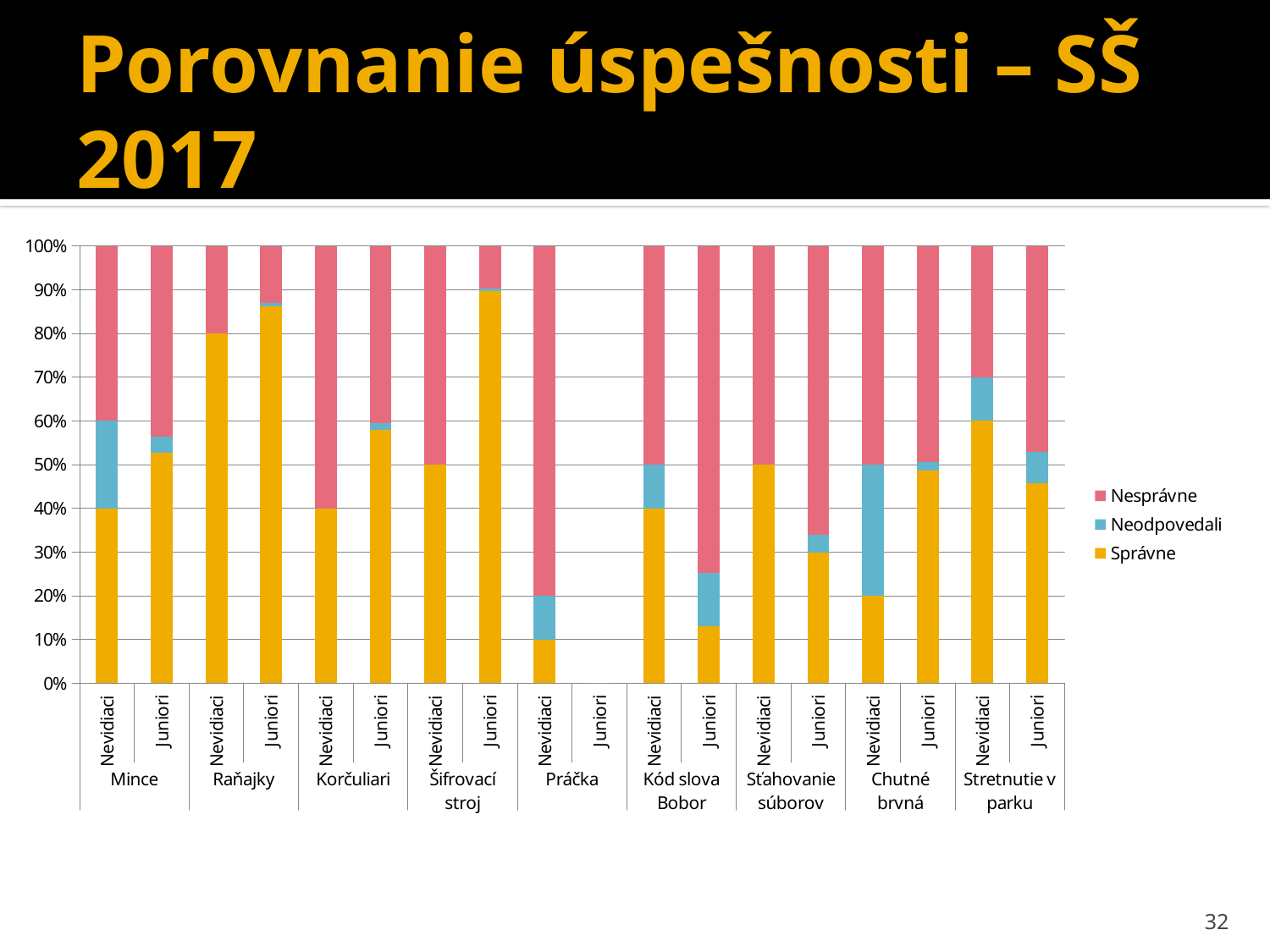
Is the Správne share for Juniori in the Raňajky task greater or less than 80%? greater How many task groups are shown along the x axis? 9 What is the Správne share for Nevidiaci in the Práčka task? 10% Which task has no bar plotted for Juniori? Práčka What is the Správne share for Nevidiaci in the Mince task? 40% Is the Správne share for Juniori in the Kód slova Bobor task greater or less than 20%? less What is the Správne share for Nevidiaci in the Raňajky task? 80% What are the three series named in the legend? Nesprávne, Neodpovedali, Správne How many series does the legend list? 3 What kind of chart is shown on the slide? Stacked bar chart In the Chutné brvná task, which group has the larger Správne share, Nevidiaci or Juniori? Juniori